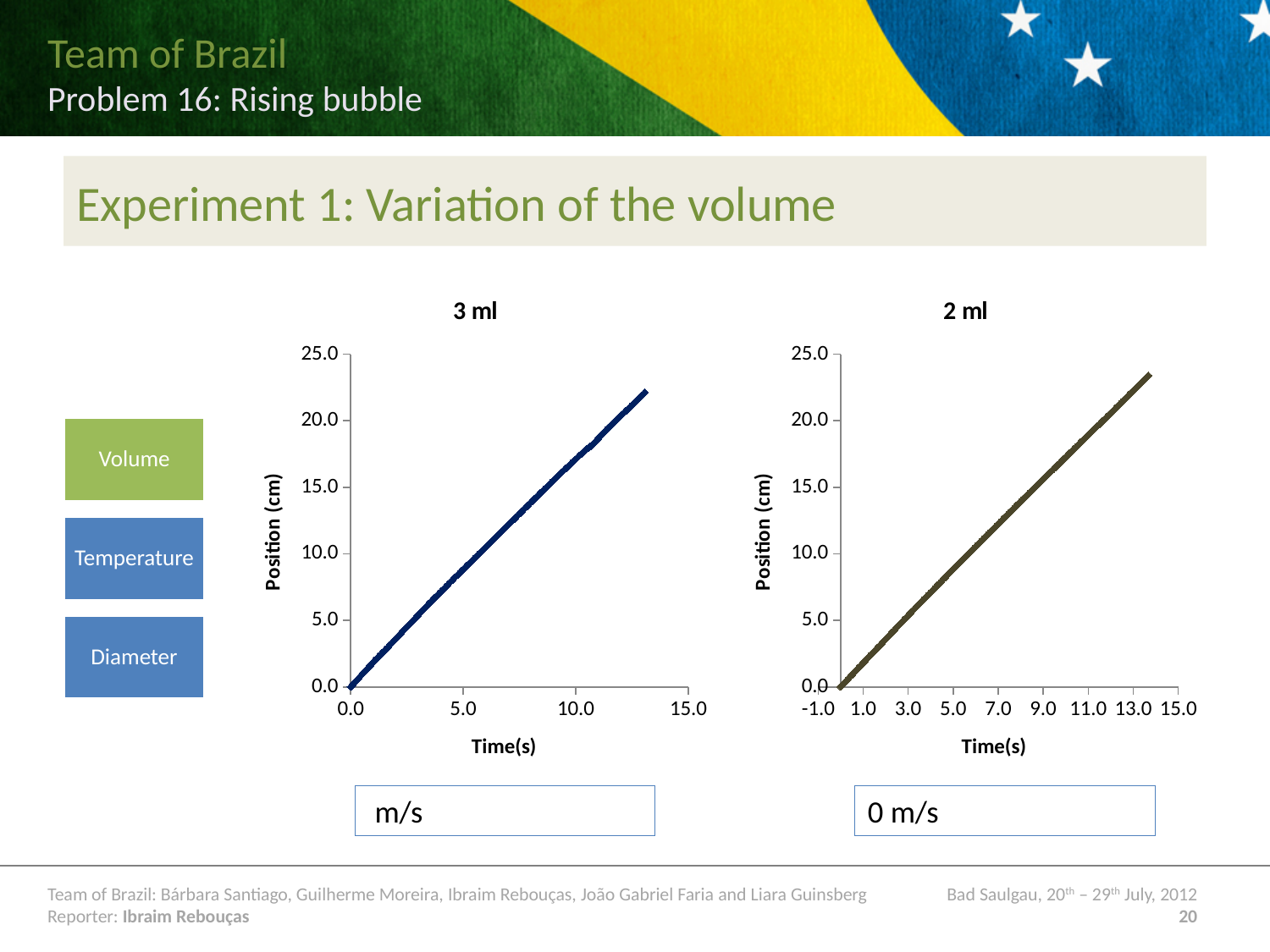
In the "2 ml" chart, does position rise or fall as time increases? rise What kind of chart is the "3 ml" chart? scatter chart In the "3 ml" chart, does position rise or fall as time increases? rise In the "3 ml" chart, is the highest plotted position greater or less than 20.0 cm? greater In the "3 ml" chart, is the position at time 5.0 s greater or less than 10.0 cm? less In the "2 ml" chart, is the highest plotted position greater or less than 25.0 cm? less How many charts are shown on the slide? 2 What is the x-axis title of the "3 ml" chart? Time(s) What is the y-axis title of the "2 ml" chart? Position (cm)